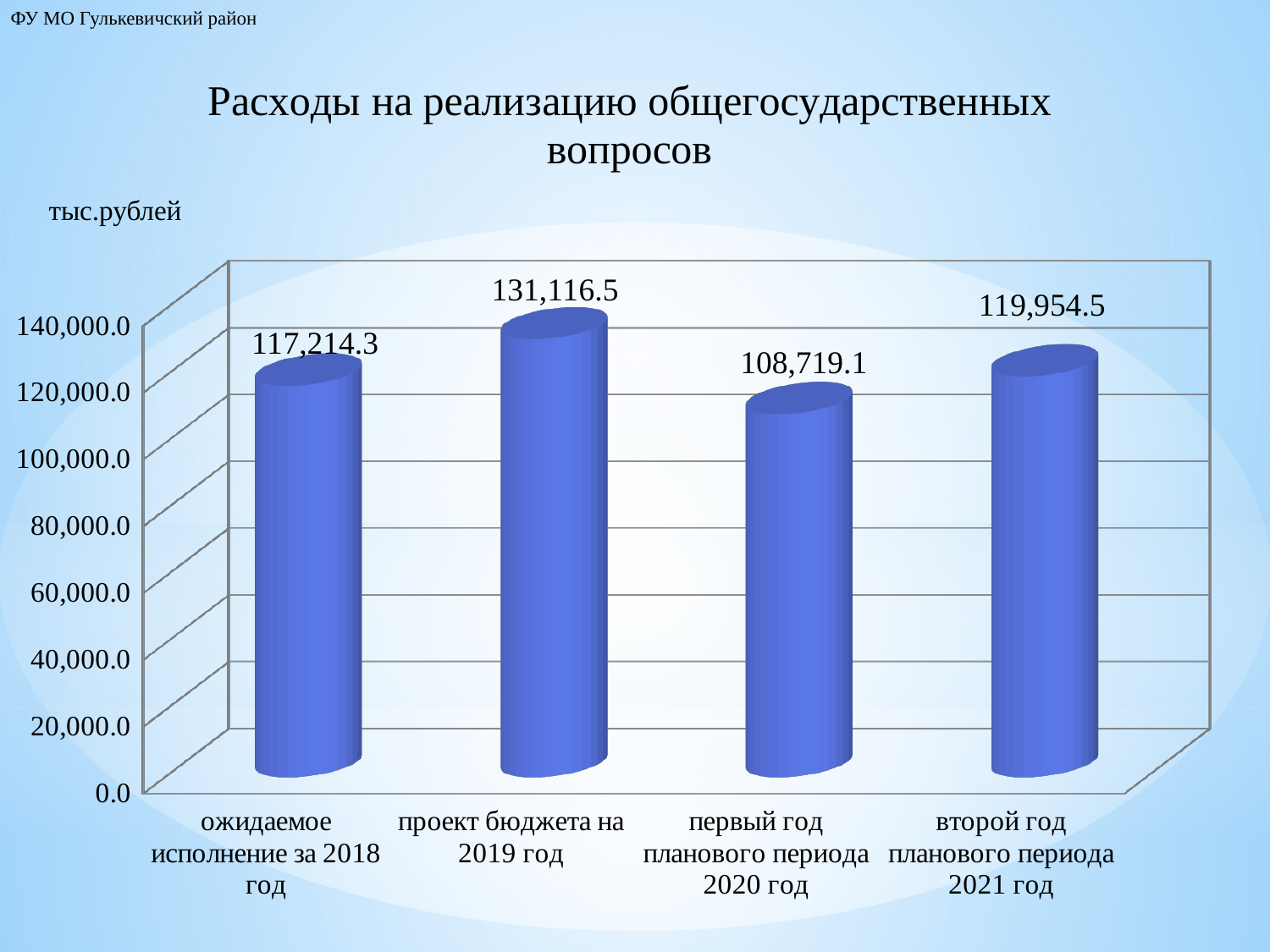
What is the value for "второй год планового периода 2021 год"? 119,954.5 What is the difference between the values for "второй год планового периода 2021 год" and "первый год планового периода 2020 год"? 11,235.4 Which category has the lowest value? первый год планового периода 2020 год What is the value for "первый год планового периода 2020 год"? 108,719.1 What is the difference between the values for "проект бюджета на 2019 год" and "ожидаемое исполнение за 2018 год"? 13,902.2 Which is larger: the value for "ожидаемое исполнение за 2018 год" or for "второй год планового периода 2021 год"? второй год планового периода 2021 год How many categories are shown on the chart? 4 Which category has the highest value? проект бюджета на 2019 год What is the value for "проект бюджета на 2019 год"? 131,116.5 What is the title of the chart? Расходы на реализацию общегосударственных вопросов What is the value for "ожидаемое исполнение за 2018 год"? 117,214.3 What kind of chart is shown on the slide? bar chart